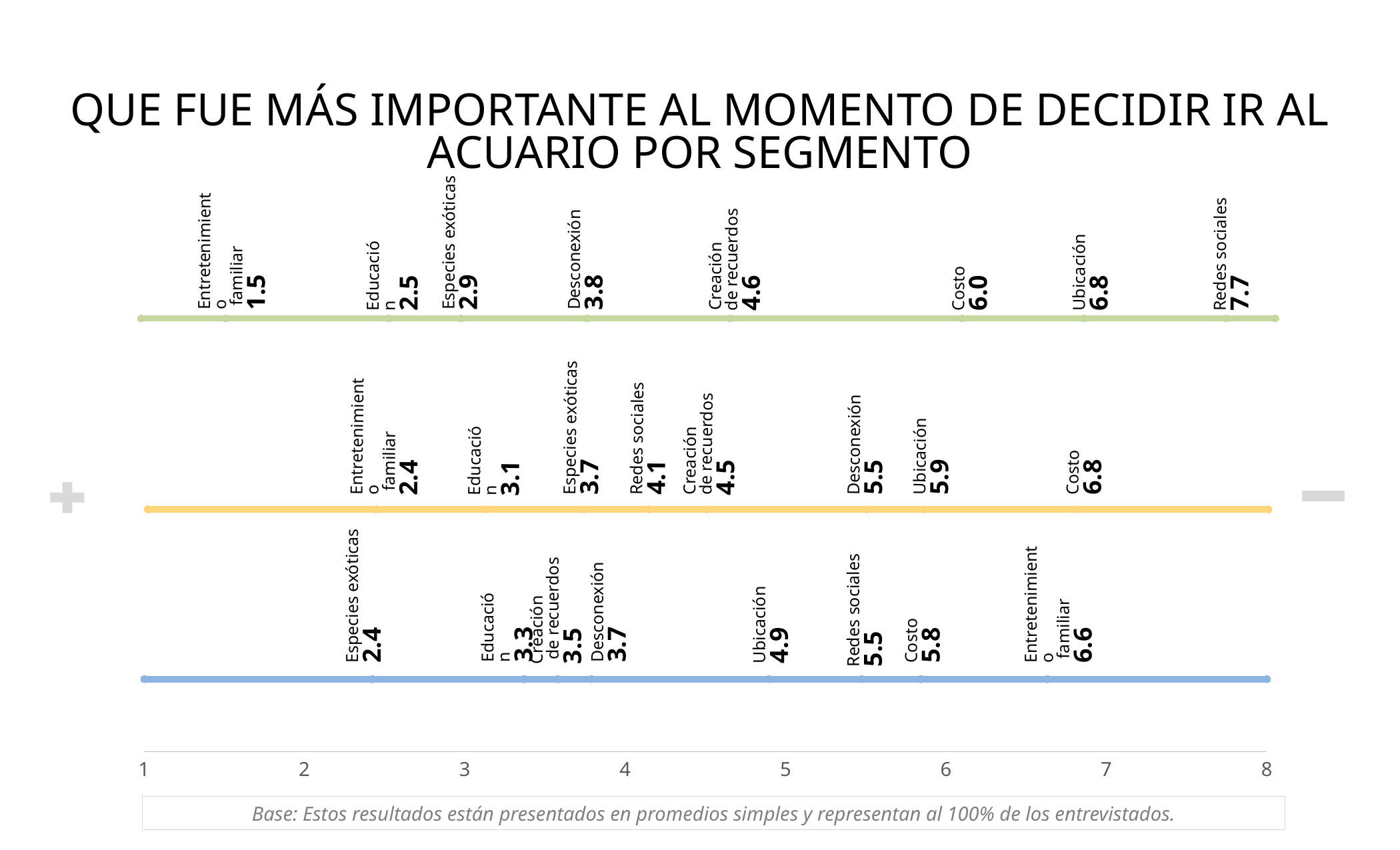
On the top (green) line, what is the value for Redes sociales? 7.7 On the middle (yellow) line, which category has the lowest value? Entretenimiento familiar On the bottom (blue) line, which category has the highest value? Entretenimiento familiar On the top (green) line, which category has the lowest value? Entretenimiento familiar On the middle (yellow) line, what is the value for Costo? 6.8 What is the highest value shown on the x axis of the chart? 8 Which is larger: Desconexión on the middle (yellow) line or Desconexión on the bottom (blue) line? Desconexión on the middle (yellow) line How many horizontal lines (segments) are plotted on the chart? 3 On the top (green) line, what is the difference between Redes sociales and Entretenimiento familiar? 6.2 On the bottom (blue) line, what is the value for Ubicación? 4.9 On the bottom (blue) line, what is the difference between Costo and Especies exóticas? 3.4 How many categories are plotted on the top (green) line? 8